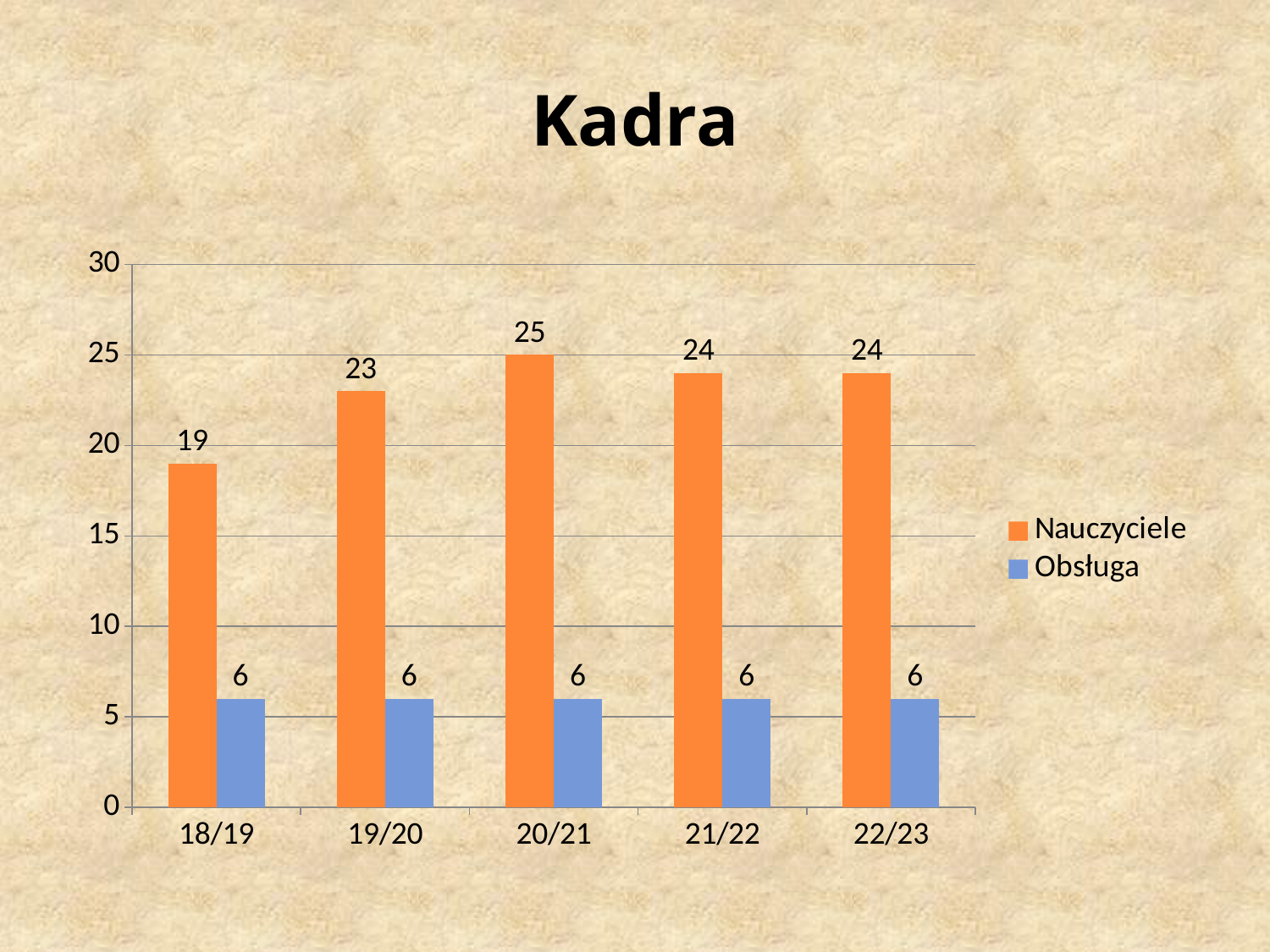
In which year is the Nauczyciele value lowest? 18/19 What is the value for Obsługa in 22/23? 6 What is the difference between the Nauczyciele values for 20/21 and 18/19? 6 What kind of chart is shown on the slide? Bar chart In which year is the Nauczyciele value highest? 20/21 How many series does the legend list? 2 What is the difference between Nauczyciele and Obsługa in 21/22? 18 What is the title of the chart? Kadra Which is larger in 19/20, Nauczyciele or Obsługa? Nauczyciele What is the value for Nauczyciele in 18/19? 19 What is the value for Nauczyciele in 20/21? 25 How many years are shown on the x axis? 5